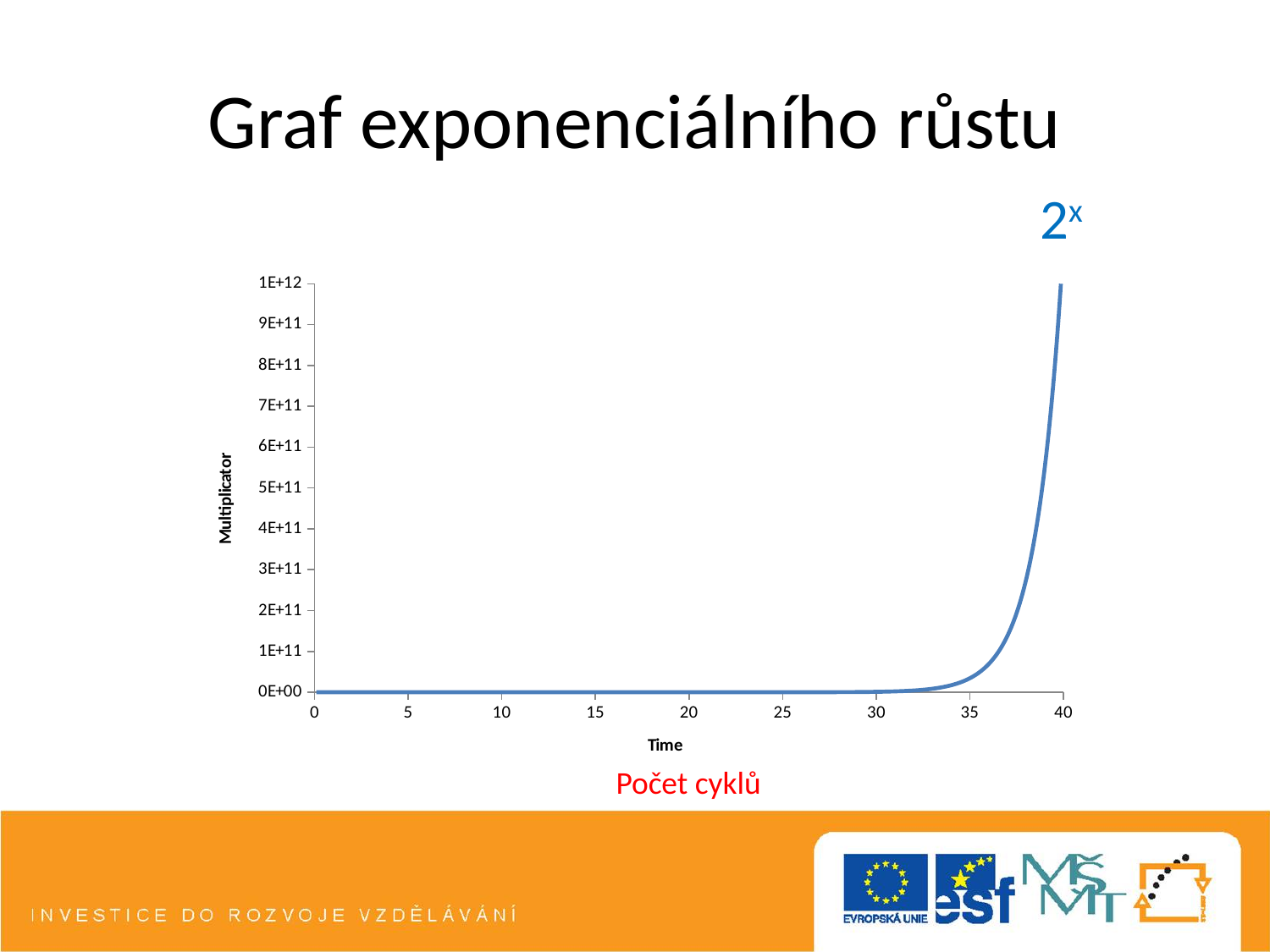
Is the Multiplicator value at Time 39 greater or less than 4E+11? greater Do the values on the chart rise or fall as Time increases from 0 to 40? rise What is the highest tick label shown on the vertical axis? 1E+12 Is the Multiplicator value at Time 20 greater or less than 1E+11? less What is the title of the horizontal axis of the chart? Time How many tick labels are shown on the horizontal axis? 9 At which Time value does the curve reach its highest Multiplicator? 40 Is the Multiplicator value at Time 30 greater or less than 1E+11? less What kind of chart is shown on the slide? line chart Which has the larger Multiplicator value, Time 35 or Time 40? Time 40